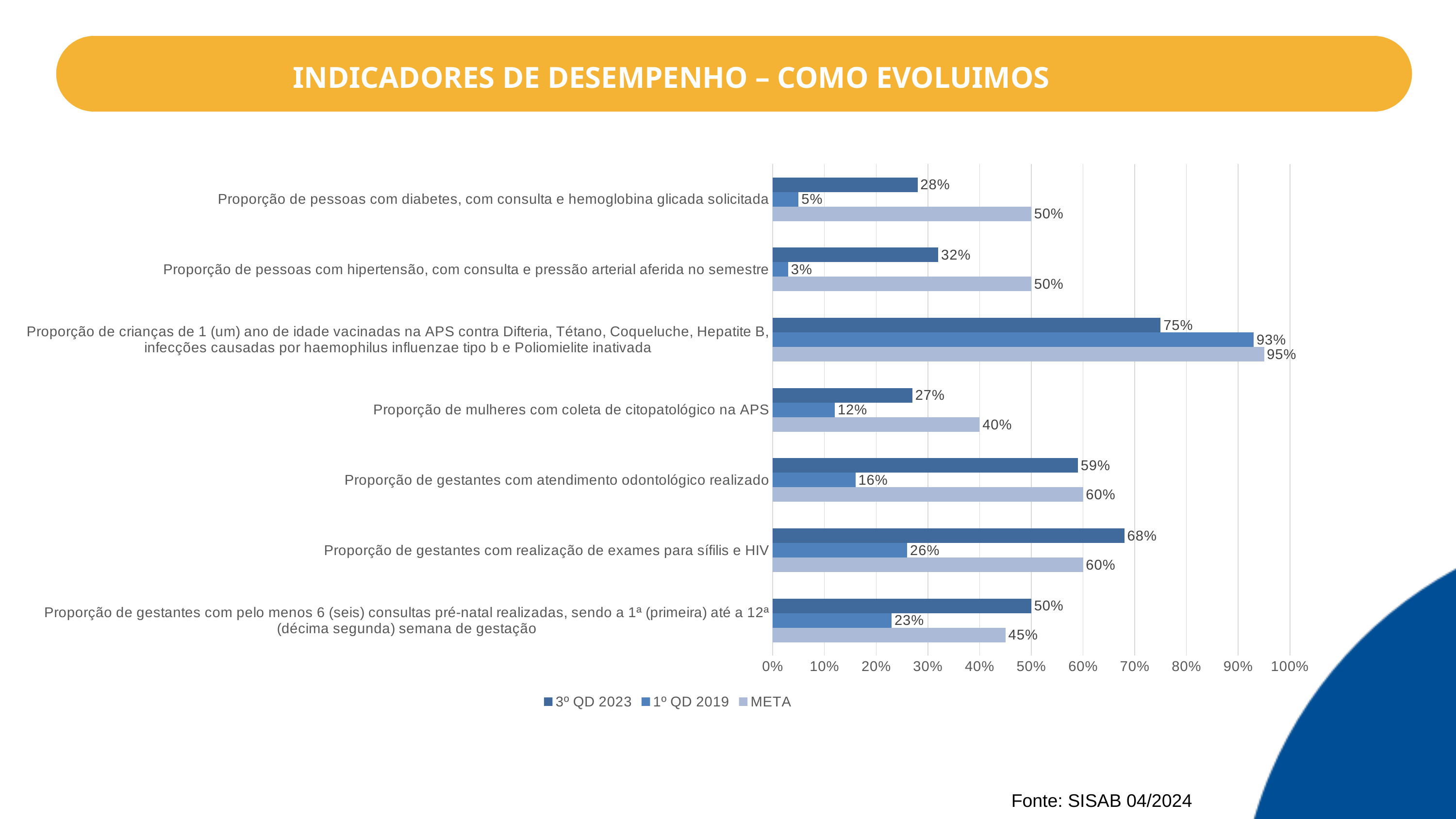
For 'Proporção de gestantes com realização de exames para sífilis e HIV', which is larger: the 3º QD 2023 value or the META value? 3º QD 2023 What is the difference between the 3º QD 2023 and 1º QD 2019 values for 'Proporção de gestantes com atendimento odontológico realizado'? 43% How many series does the legend list? 3 Which category has the highest 3º QD 2023 value? Proporção de crianças de 1 (um) ano de idade vacinadas na APS contra Difteria, Tétano, Coqueluche, Hepatite B, infecções causadas por haemophilus influenzae tipo b e Poliomielite inativada What is the META value for 'Proporção de mulheres com coleta de citopatológico na APS'? 40% What is the 3º QD 2023 value for 'Proporção de pessoas com diabetes, com consulta e hemoglobina glicada solicitada'? 28% Which category has the lowest 1º QD 2019 value? Proporção de pessoas com hipertensão, com consulta e pressão arterial aferida no semestre What is the 1º QD 2019 value for 'Proporção de gestantes com pelo menos 6 (seis) consultas pré-natal realizadas, sendo a 1ª (primeira) até a 12ª (décima segunda) semana de gestação'? 23% What is the 1º QD 2019 value for 'Proporção de pessoas com hipertensão, com consulta e pressão arterial aferida no semestre'? 3% How many categories are shown on the chart? 7 What is the source cited at the bottom of the slide? Fonte: SISAB 04/2024 What kind of chart is shown on the slide? Bar chart